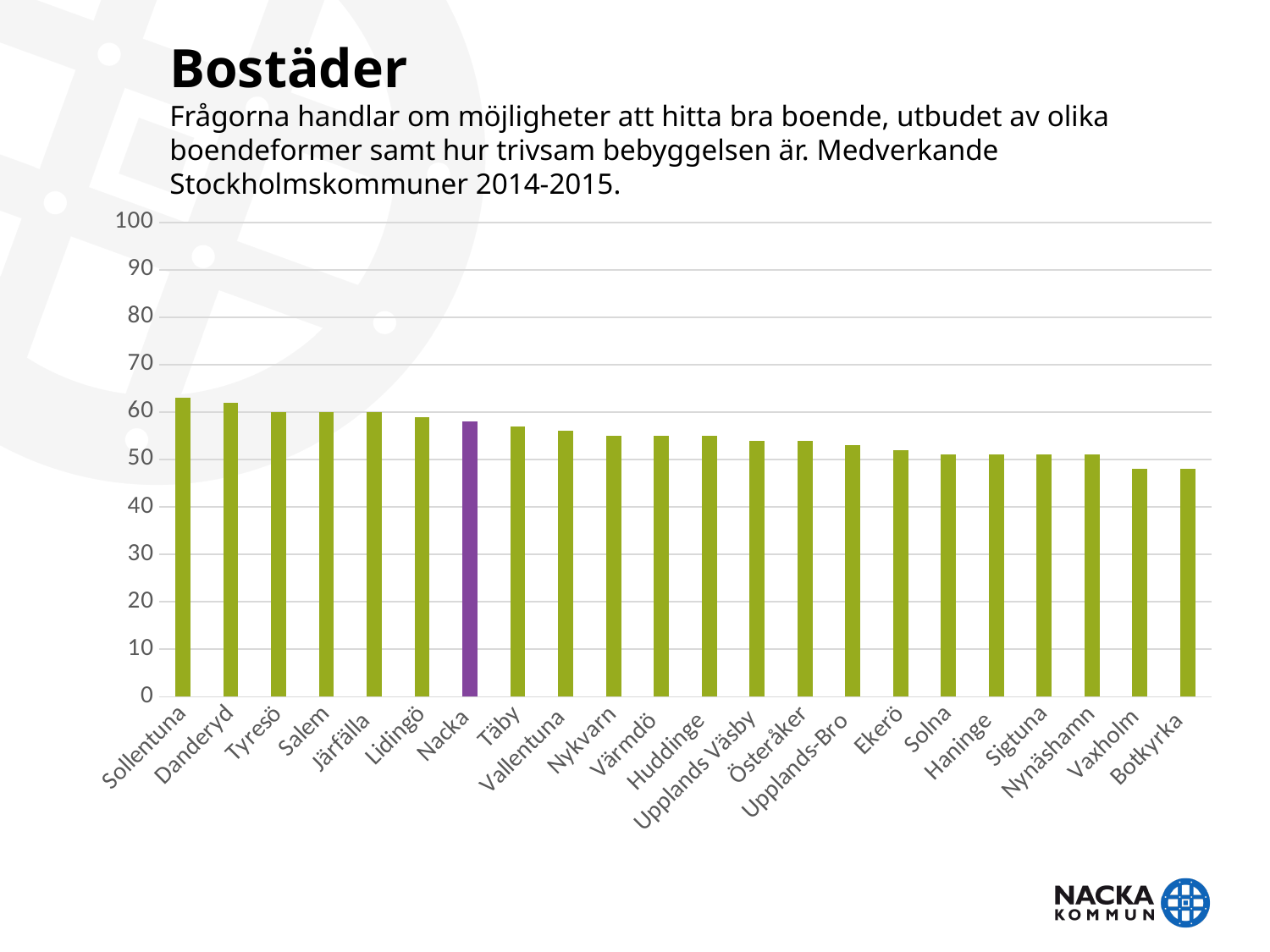
Is the value for Botkyrka greater or less than 50? less What kind of chart is shown on the slide? bar chart Which municipality's bar is shown in a different colour (purple) from the others? Nacka Is the value for Vaxholm greater or less than 60? less Which has the larger value, Sollentuna or Botkyrka? Sollentuna Is the value for Nacka greater or less than 50? greater Do the bar values rise or fall from left to right along the x axis? fall What is the title of the slide containing the chart? Bostäder How many municipalities are shown on the x axis of the chart? 22 Which has the larger value, Nacka or Vaxholm? Nacka